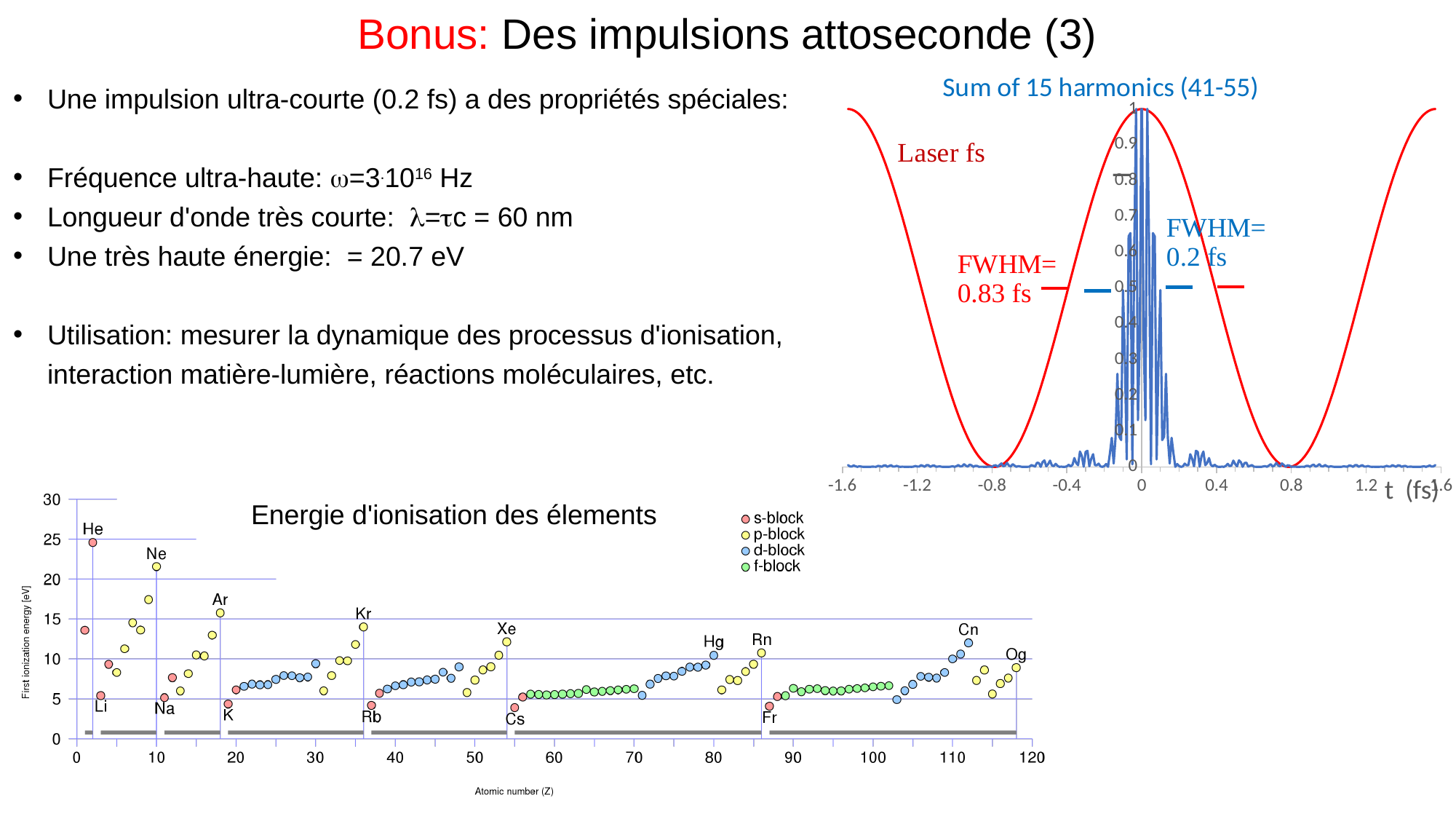
In the bottom chart "Energie d'ionisation des élements", is the value for Xe greater or less than 10? greater In the bottom chart "Energie d'ionisation des élements", which colour marks the d-block series? blue In the bottom chart "Energie d'ionisation des élements", is the value for Li greater or less than 10? less In the top-right chart "Sum of 15 harmonics (41-55)", what FWHM is given for the red laser curve? 0.83 fs What kind of chart is the bottom chart titled "Energie d'ionisation des élements"? scatter chart What kind of chart is the top-right chart titled "Sum of 15 harmonics (41-55)"? line chart In the bottom chart "Energie d'ionisation des élements", which has the larger value, Cn or Og? Cn In the bottom chart "Energie d'ionisation des élements", which has the larger value, Ar or Kr? Ar In the top-right chart "Sum of 15 harmonics (41-55)", what FWHM is given for the blue harmonic sum pulse? 0.2 fs In the bottom chart "Energie d'ionisation des élements", is the value for He greater or less than 20? greater In the bottom chart "Energie d'ionisation des élements", which element has the highest first ionization energy? He In the bottom chart "Energie d'ionisation des élements", how many series does the legend list? 4